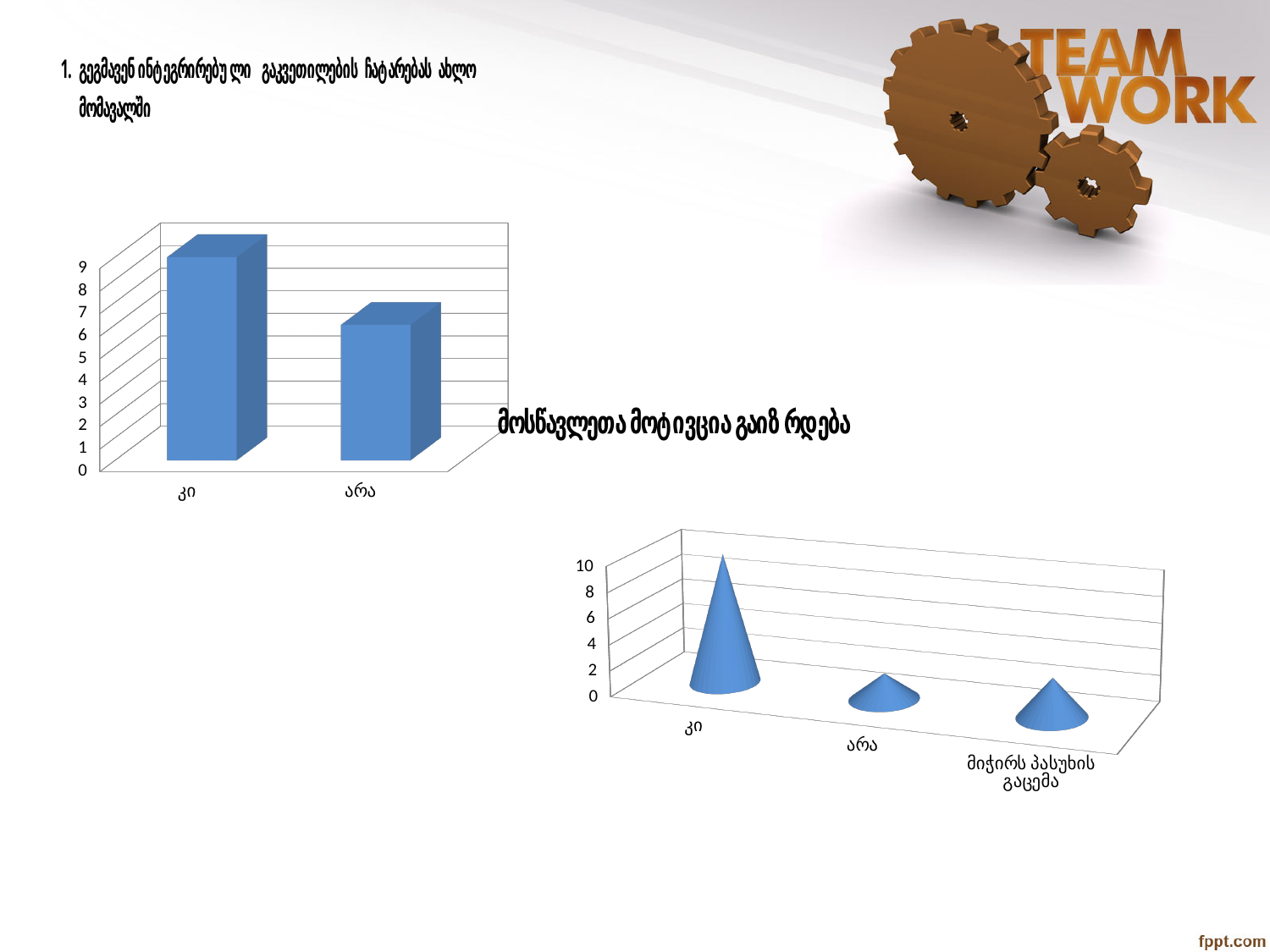
In the chart on the right, is the value for კი greater or less than 6? greater In the chart on the left, which is larger, the value for კი or the value for არა? კი What kind of chart is the chart on the left? bar chart In the chart on the left, is the value for არა greater or less than 8? less In the chart on the left, which category has the lowest value? არა In the chart on the right, is the value for არა greater or less than 4? less How many categories are shown in the chart on the left? 2 In the chart on the left, which category has the highest value? კი How many categories are shown in the chart on the right? 3 In the chart on the right, which category has the highest value? კი In the chart on the right, which is larger, the value for კი or the value for მიჭირს პასუხის გაცემა? კი